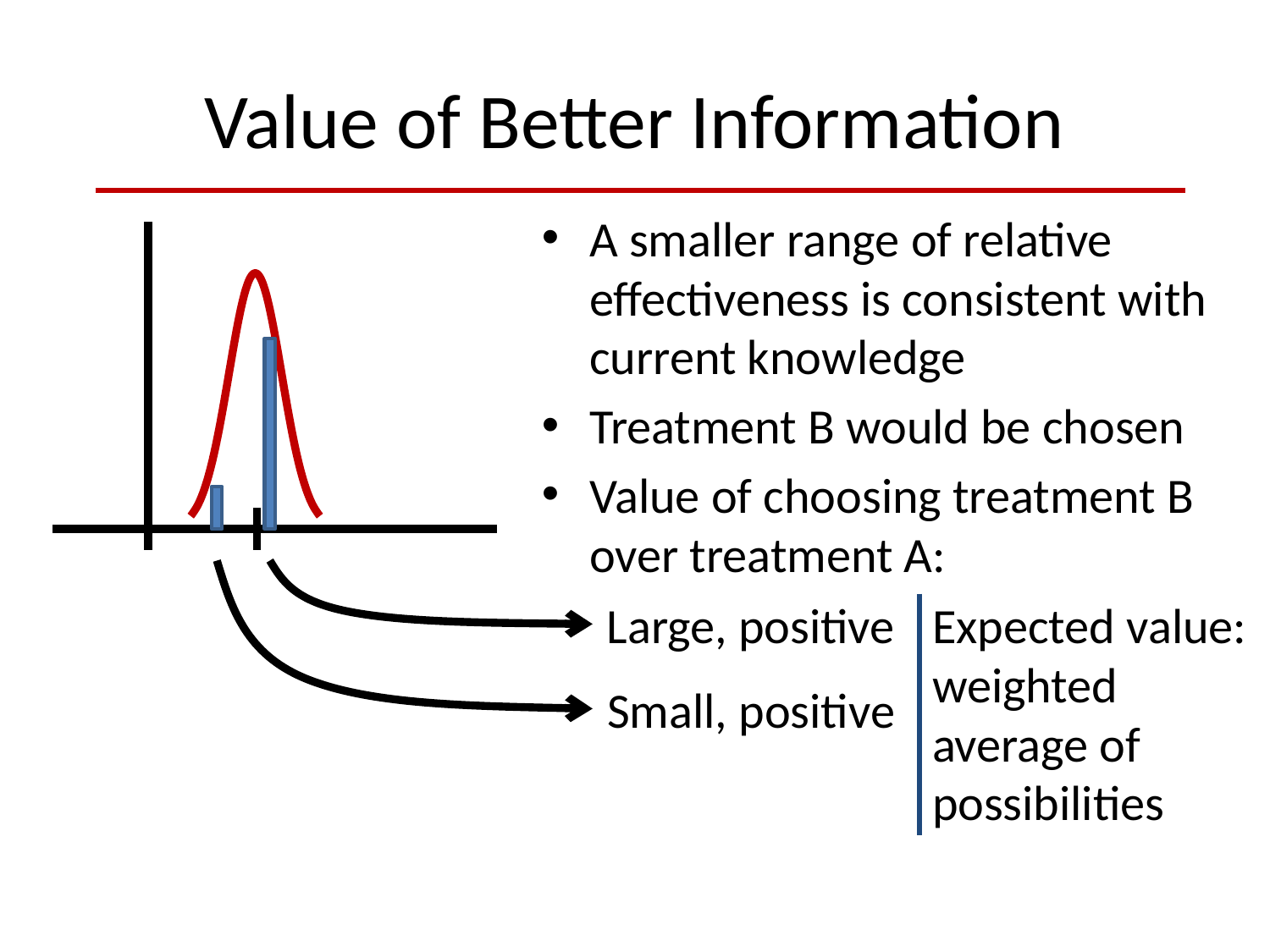
Which bar is taller: the one labelled "Large, positive" or the one labelled "Small, positive"? Large, positive What colour is the curve drawn over the bars? Red Which labelled possibility corresponds to the shortest bar on the diagram? Small, positive What is the title of the slide containing the diagram? Value of Better Information Which labelled possibility corresponds to the tallest bar on the diagram? Large, positive How many blue bars are drawn on the diagram? 2